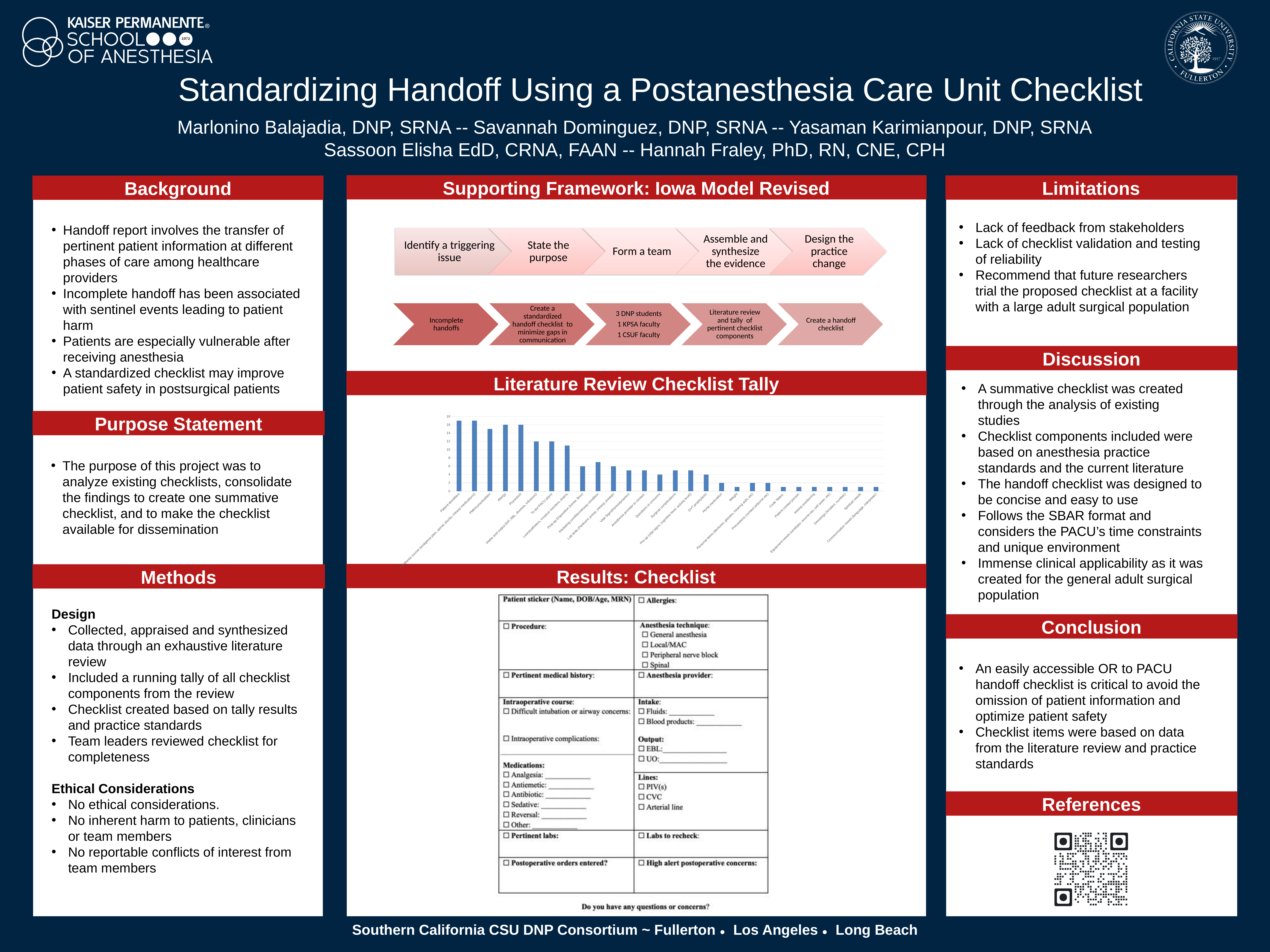
In the Literature Review Checklist Tally chart, which is larger: the leftmost bar or the rightmost bar? the leftmost bar In the Literature Review Checklist Tally chart, is the value of the last (rightmost) bar greater or less than 4? less In the Literature Review Checklist Tally chart, is the value of the first (leftmost) bar greater or less than 14? greater In the Literature Review Checklist Tally chart, are the tallest bars at the left end or the right end of the chart? left end In the Literature Review Checklist Tally chart, do the bar values generally rise or fall from left to right? fall What is the highest tick value shown on the y axis of the Literature Review Checklist Tally chart? 18 What kind of chart is shown under the heading 'Literature Review Checklist Tally'? bar chart What is the title of the bar chart in the middle column of the poster? Literature Review Checklist Tally